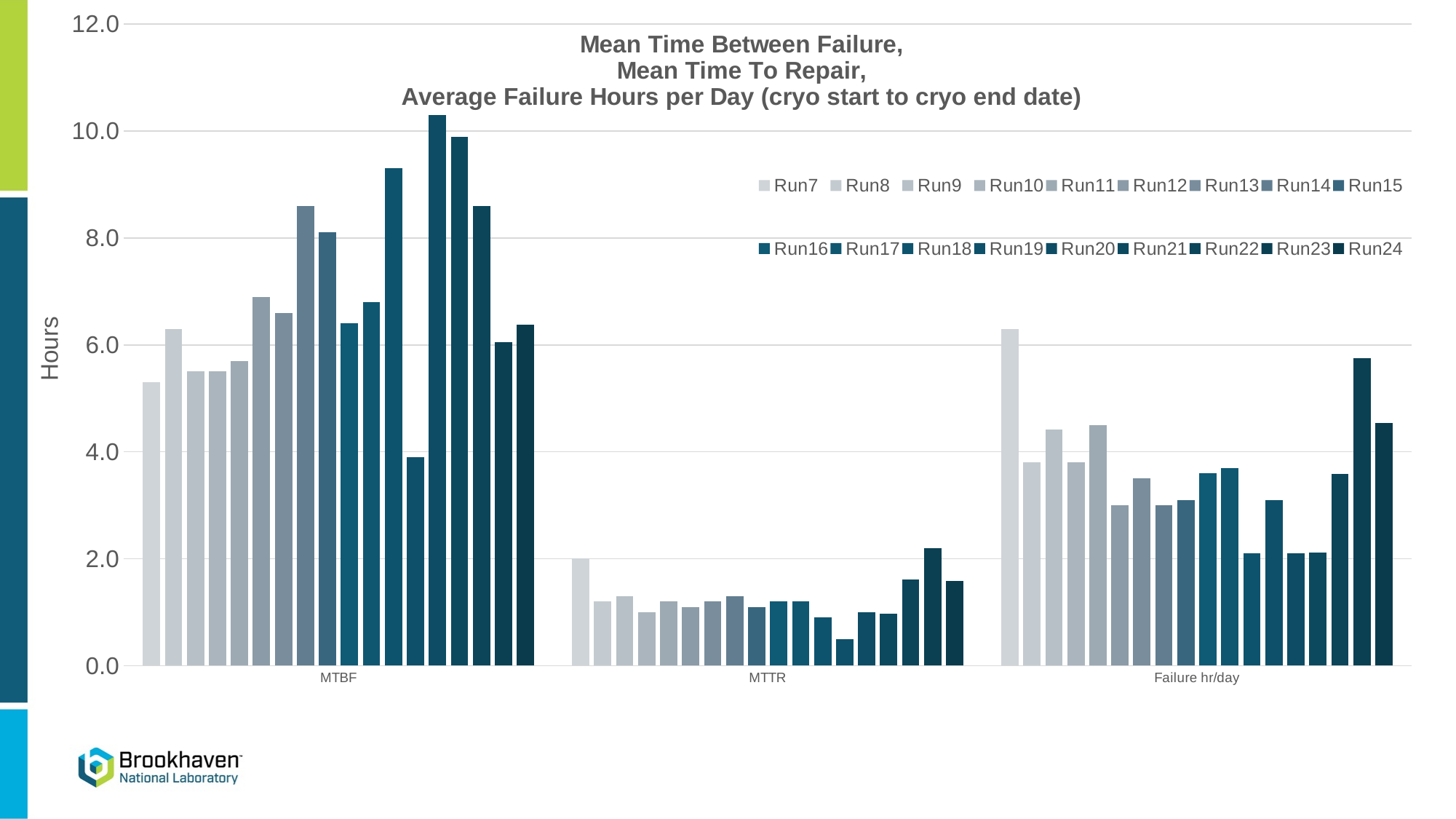
Is the Run7 value for MTTR greater or less than 1.0? greater Which category has the lowest bars overall? MTTR Is the Run7 value for Failure hr/day greater or less than 6.0? greater Which category contains the tallest bar in the chart? MTBF Is the Run24 value for Failure hr/day greater or less than 4.0? greater What is the highest value shown on the y axis? 12.0 What is the label of the y axis? Hours What kind of chart is shown on the slide? bar chart How many series does the legend list? 18 How many categories are shown on the x axis? 3